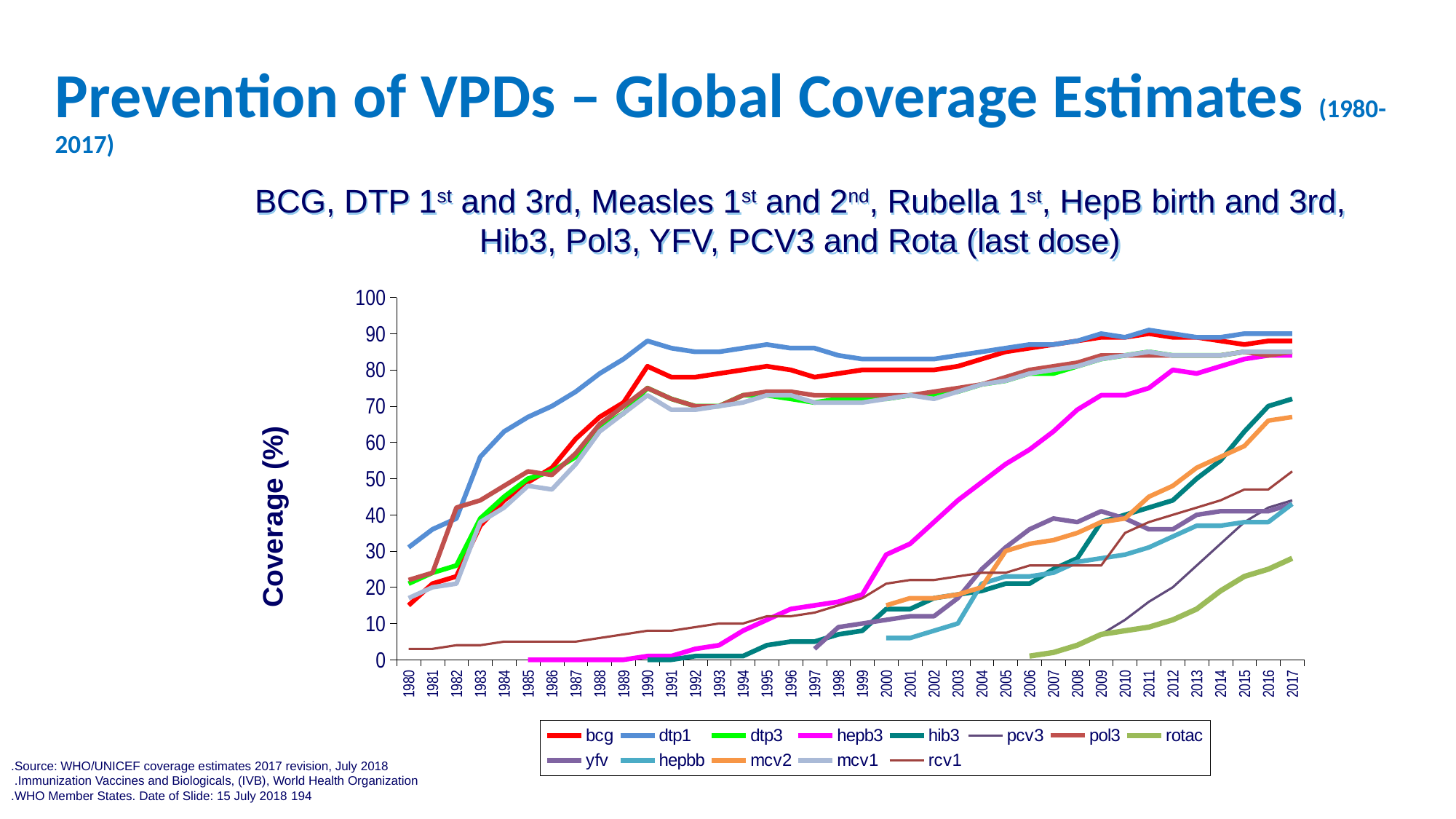
How many series does the legend list? 13 Is the value for dtp1 in 1990 greater or less than 80? greater Is the value for hepb3 in 1995 greater or less than 20? less Which series has the highest value in 1990? dtp1 Is the value for rotac in 2017 greater or less than 40? less How many years are shown along the x axis? 38 What is the label of the y axis? Coverage (%) Does the hepb3 series rise or fall from 1985 to 2017? rise What kind of chart is shown on the slide? line chart Which series has the lowest value in 2017? rotac In 2010, which is larger, hepb3 or rotac? hepb3